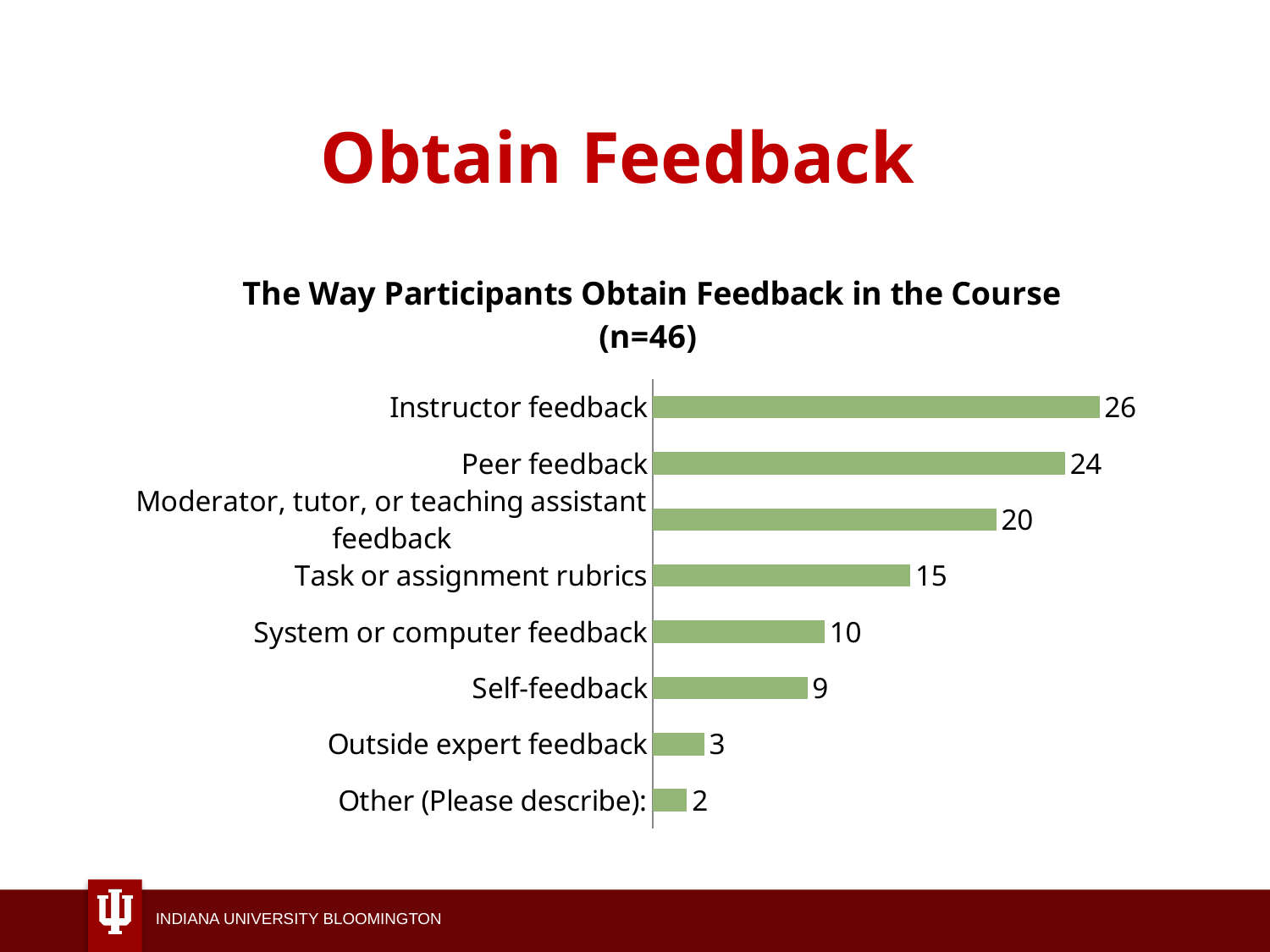
What is the value for Self-feedback? 9 What is the value for Instructor feedback? 26 What is the difference between System or computer feedback and Outside expert feedback? 7 Which category has the lowest value? Other (Please describe): Which is larger, Peer feedback or Task or assignment rubrics? Peer feedback What is the difference between Peer feedback and Moderator, tutor, or teaching assistant feedback? 4 What is the value for Task or assignment rubrics? 15 How many categories are shown in the chart? 8 What is the sample size (n) stated in the chart title? 46 What is the title of the chart? The Way Participants Obtain Feedback in the Course (n=46) What kind of chart is this? Bar chart Which category has the highest value? Instructor feedback